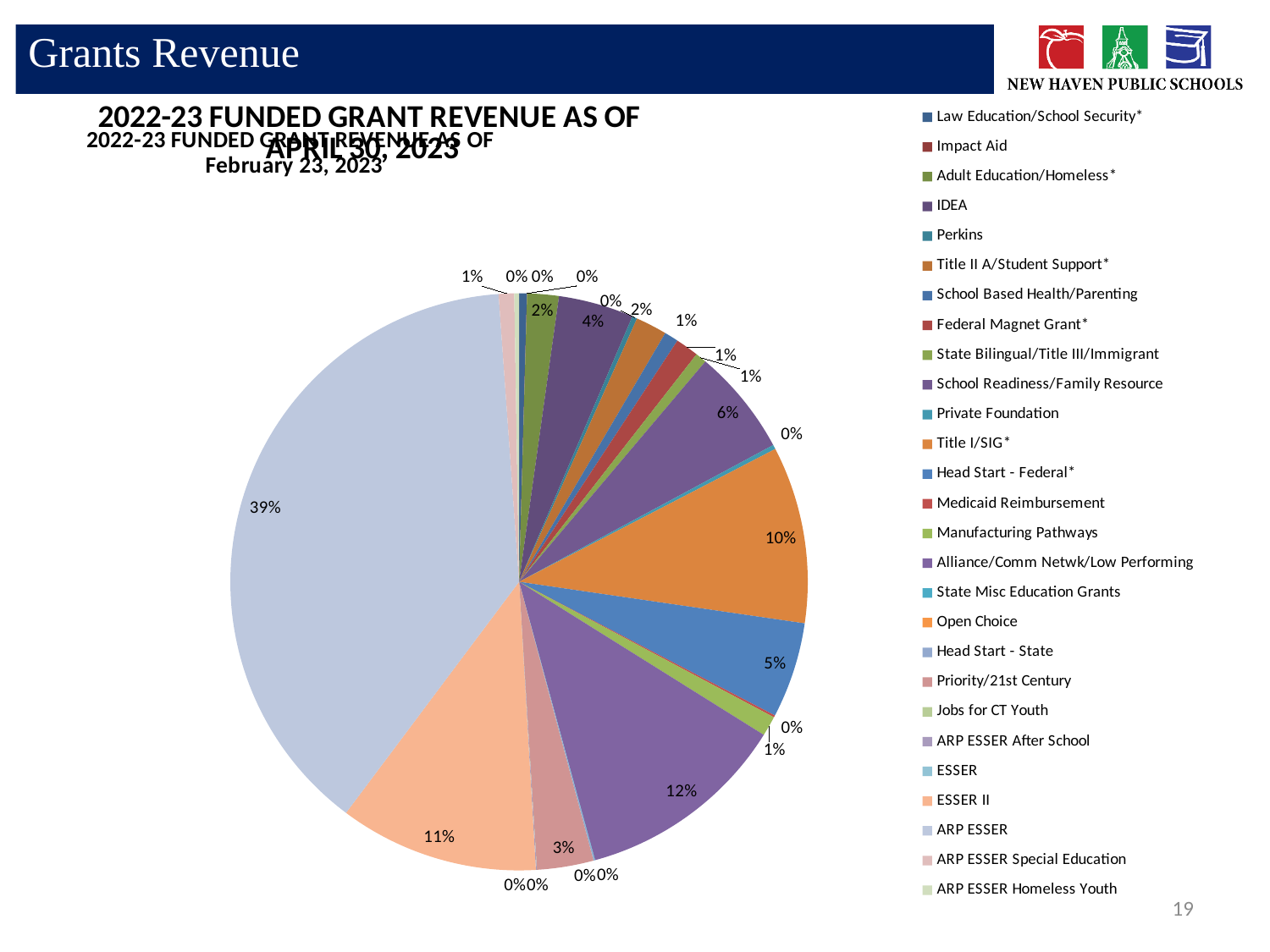
What is the last category listed in the legend? ARP ESSER Homeless Youth What share of the pie does Head Start - Federal* represent? 5% What share of the pie does Title I/SIG* represent? 10% Which is larger, the share for ARP ESSER or the share for ESSER II? ARP ESSER What share of the pie does ARP ESSER represent? 39% What kind of chart is shown on the slide? Pie chart How many categories are listed in the legend? 27 What is the difference in percentage points between the ARP ESSER share (39%) and the ESSER II share (11%)? 28 percentage points What is the first category listed in the legend? Law Education/School Security* Which category has the largest share of the pie? ARP ESSER